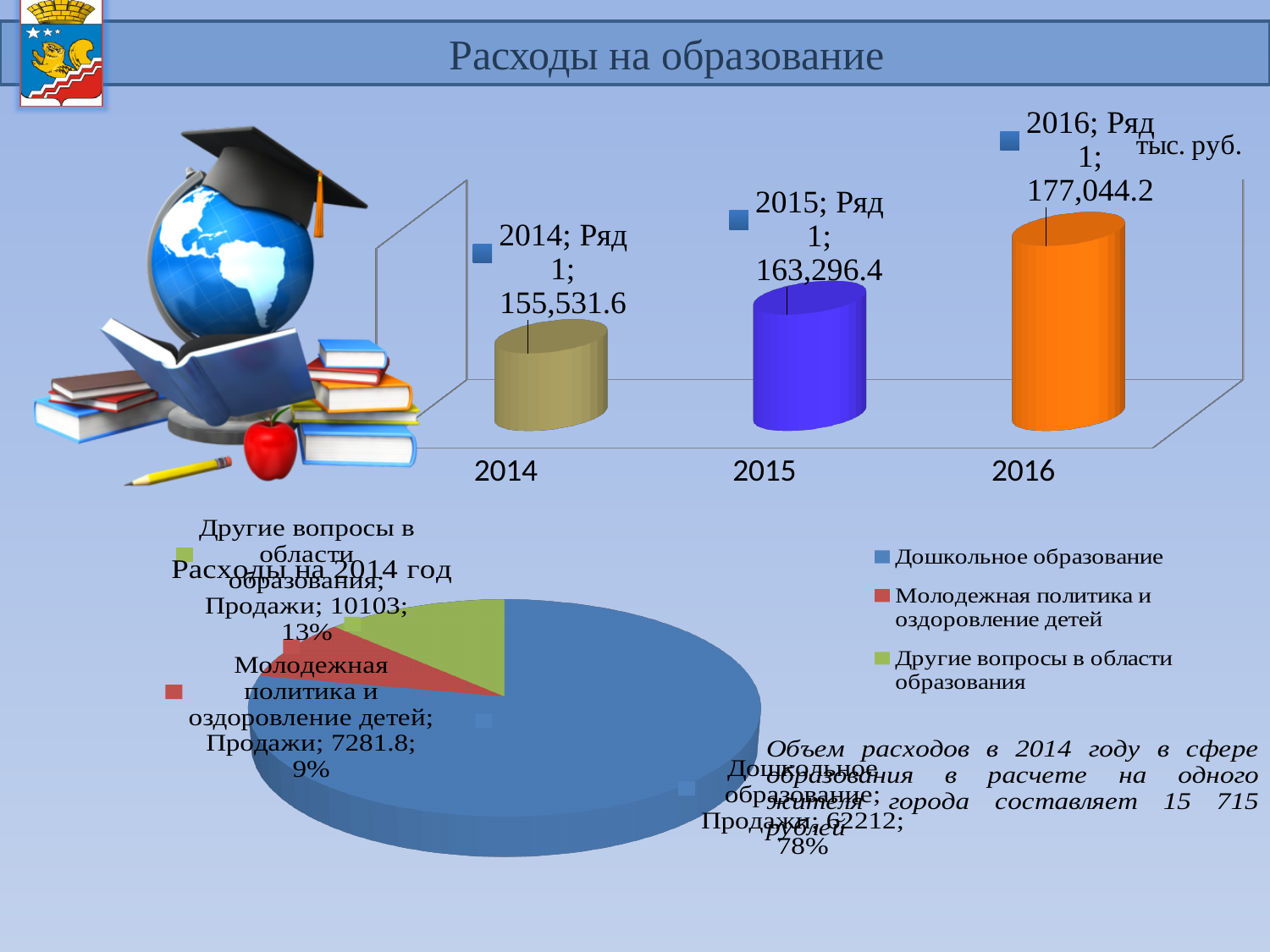
How many entries does the legend of the pie chart 'Расходы на 2014 год' list? 3 On the bar chart at the top of the slide, what is the value for 2014? 155,531.6 On the bar chart at the top of the slide, how many years are shown? 3 On the bar chart at the top of the slide, which year has the lowest value? 2014 What kind of chart is the chart at the top of the slide? bar chart On the bar chart at the top of the slide, which year has the highest value? 2016 On the bar chart at the top of the slide, what is the difference between the values for 2016 and 2015? 13,747.8 On the pie chart 'Расходы на 2014 год', what is the value for 'Молодежная политика и оздоровление детей'? 7281.8 On the bar chart at the top of the slide, do the values rise or fall from 2014 to 2016? rise On the bar chart at the top of the slide, what is the value for 2016? 177,044.2 On the pie chart 'Расходы на 2014 год', what share does 'Дошкольное образование' have? 78% On the pie chart 'Расходы на 2014 год', which category has the smallest share? Молодежная политика и оздоровление детей